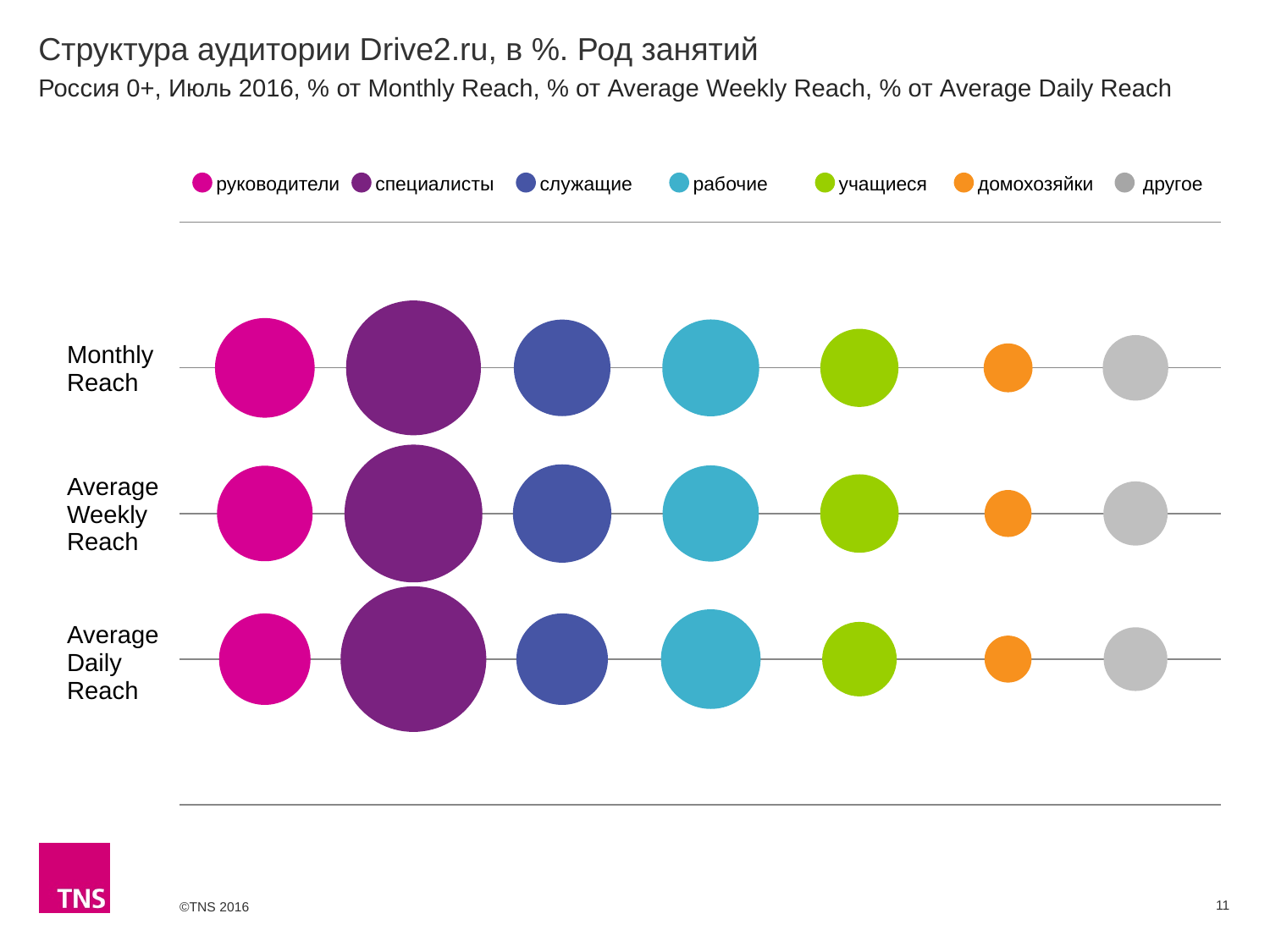
In the Average Weekly Reach row, which bubble is larger: руководители or домохозяйки? руководители What colour is used for the category 'рабочие' in the legend? light blue Which occupation category is shown in orange? домохозяйки In the Average Daily Reach row, which bubble is larger: специалисты or служащие? специалисты In the Average Weekly Reach row, which occupation category has the smallest bubble? домохозяйки How many occupation categories does the legend list? 7 In the Monthly Reach row, which occupation category has the smallest bubble? домохозяйки What kind of chart is shown on the slide? bubble chart In the Monthly Reach row, which occupation category has the largest bubble? специалисты How many reach rows (Monthly, Weekly, Daily) are plotted on the chart? 3 In the Average Daily Reach row, which occupation category has the largest bubble? специалисты